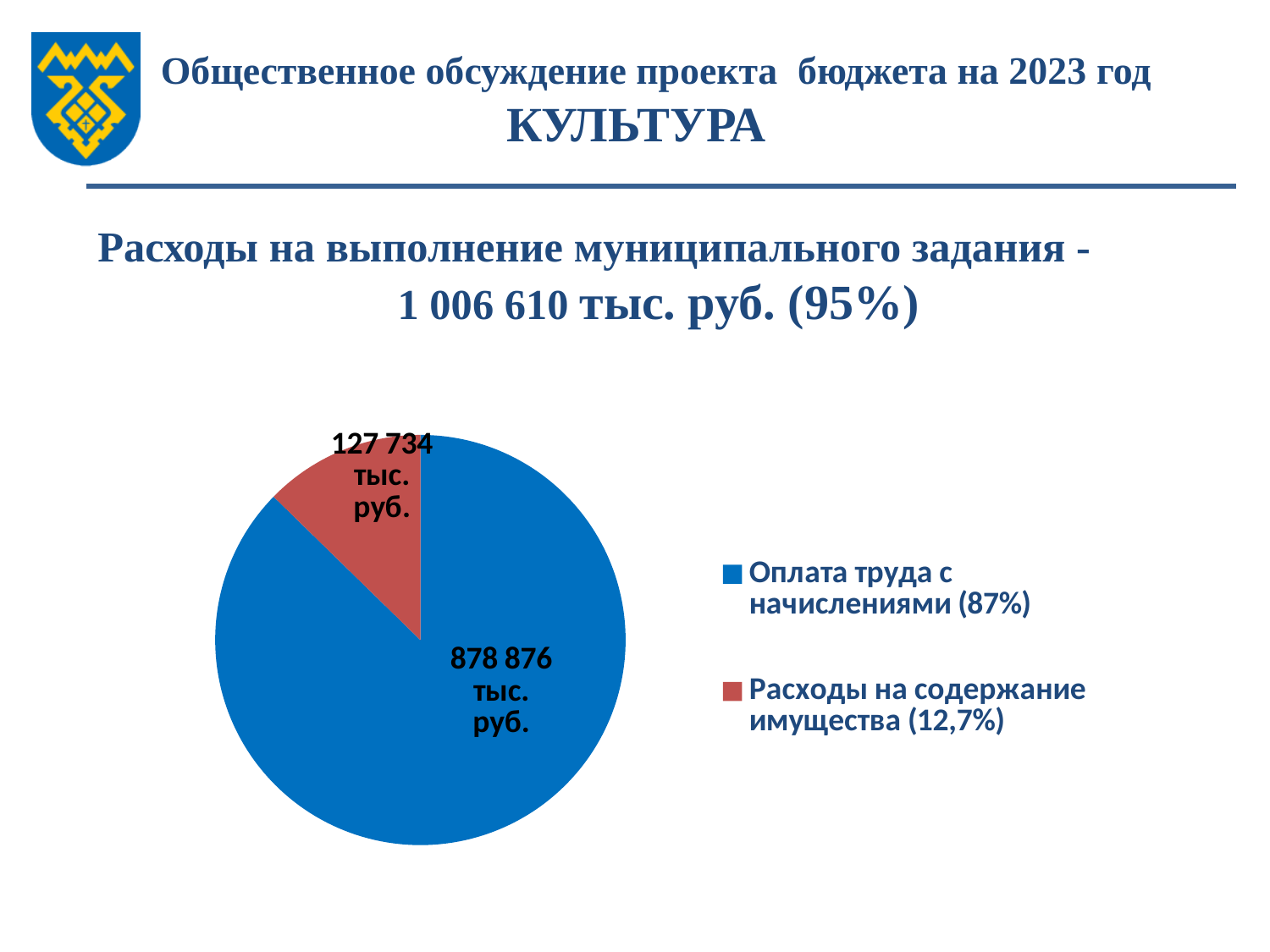
What is the difference between the value for Оплата труда с начислениями and the value for Расходы на содержание имущества? 751 142 тыс. руб. Which category has the smallest slice of the pie? Расходы на содержание имущества How many entries does the legend list? 2 What is the value for Расходы на содержание имущества? 127 734 тыс. руб. What is the value for Оплата труда с начислениями? 878 876 тыс. руб. How many slices does the pie chart have? 2 What share of the pie does Оплата труда с начислениями represent, according to the legend? 87% Which is larger: Оплата труда с начислениями or Расходы на содержание имущества? Оплата труда с начислениями Which category has the largest slice of the pie? Оплата труда с начислениями What type of chart is shown on the slide? pie chart What colour is the slice for Расходы на содержание имущества? red What share of the pie does Расходы на содержание имущества represent, according to the legend? 12,7%